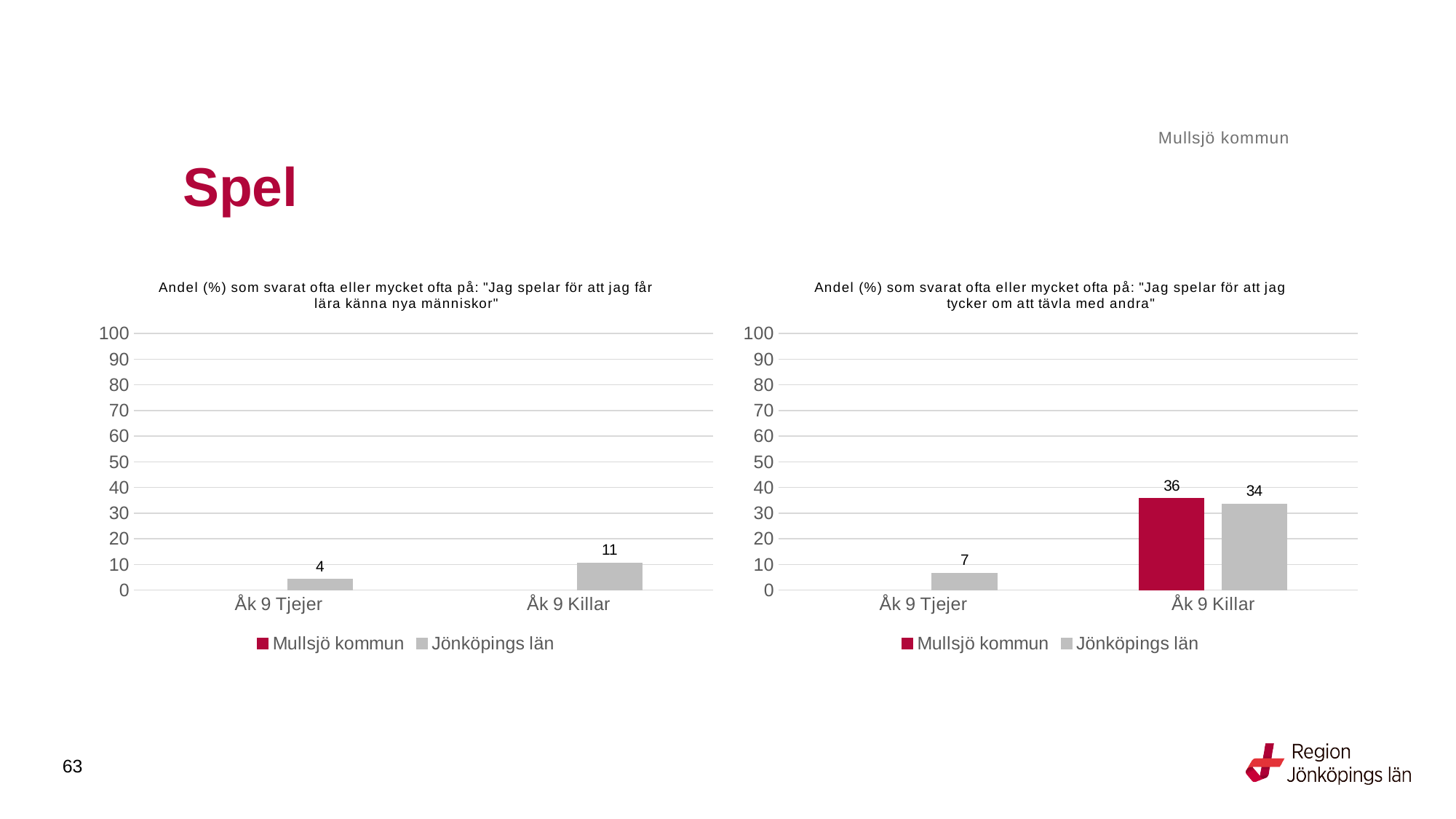
What kind of chart is the left chart ("Jag spelar för att jag får lära känna nya människor")? Bar chart In the left chart ("Jag spelar för att jag får lära känna nya människor"), what is the value for Jönköpings län for Åk 9 Killar? 11 In the left chart ("Jag spelar för att jag får lära känna nya människor"), which category has the higher Jönköpings län value? Åk 9 Killar In the right chart ("Jag spelar för att jag tycker om att tävla med andra"), what is the value for Mullsjö kommun for Åk 9 Killar? 36 In the right chart ("Jag spelar för att jag tycker om att tävla med andra"), is the Jönköpings län value for Åk 9 Killar greater or less than 30? greater In the left chart ("Jag spelar för att jag får lära känna nya människor"), what is the difference between the Jönköpings län values for Åk 9 Killar and Åk 9 Tjejer? 7 In the right chart ("Jag spelar för att jag tycker om att tävla med andra"), how many series does the legend list? 2 In the left chart ("Jag spelar för att jag får lära känna nya människor"), what is the value for Jönköpings län for Åk 9 Tjejer? 4 In the right chart ("Jag spelar för att jag tycker om att tävla med andra"), what is the difference between Mullsjö kommun and Jönköpings län for Åk 9 Killar? 2 In the right chart ("Jag spelar för att jag tycker om att tävla med andra"), what is the value for Jönköpings län for Åk 9 Killar? 34 In the right chart ("Jag spelar för att jag tycker om att tävla med andra"), what is the value for Jönköpings län for Åk 9 Tjejer? 7 In the right chart ("Jag spelar för att jag tycker om att tävla med andra"), which colour represents Mullsjö kommun in the legend? Red